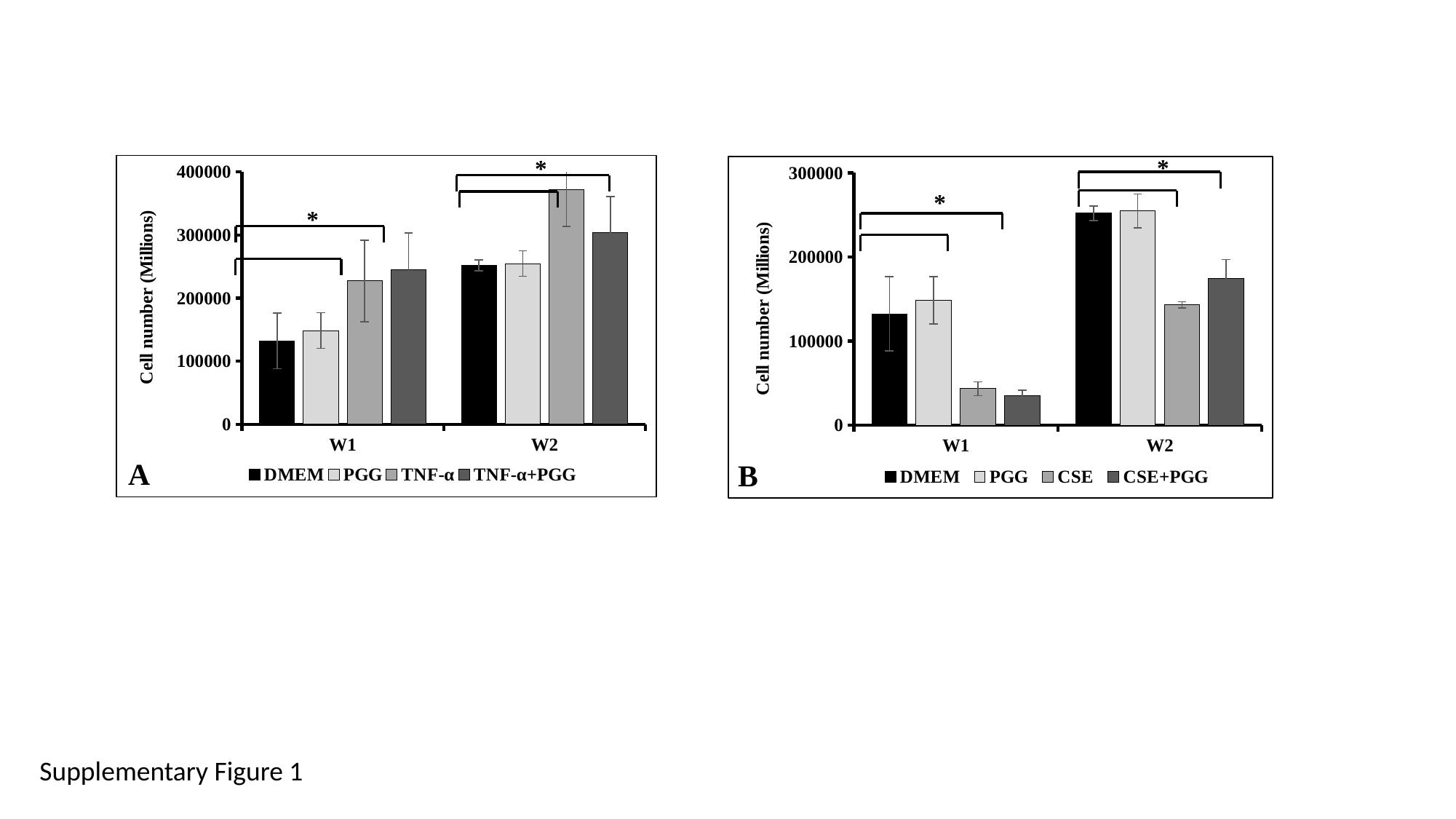
In chart A, which series has the highest bar at W2? TNF-α In chart B, is the value for DMEM at W2 greater or less than 200000? greater In chart B, which is larger at W2: the CSE bar or the CSE+PGG bar? CSE+PGG What is the y-axis title of chart B? Cell number (Millions) How many series does the legend of chart B list? 4 In chart B, is the value for CSE at W1 greater or less than 100000? less In chart A, does the DMEM value rise or fall from W1 to W2? rise In chart B, which series has the lowest bar at W1? CSE+PGG In chart A, is the value for TNF-α at W2 greater or less than 300000? greater How many categories are shown on the x axis of chart A? 2 What kind of chart is chart A? bar chart